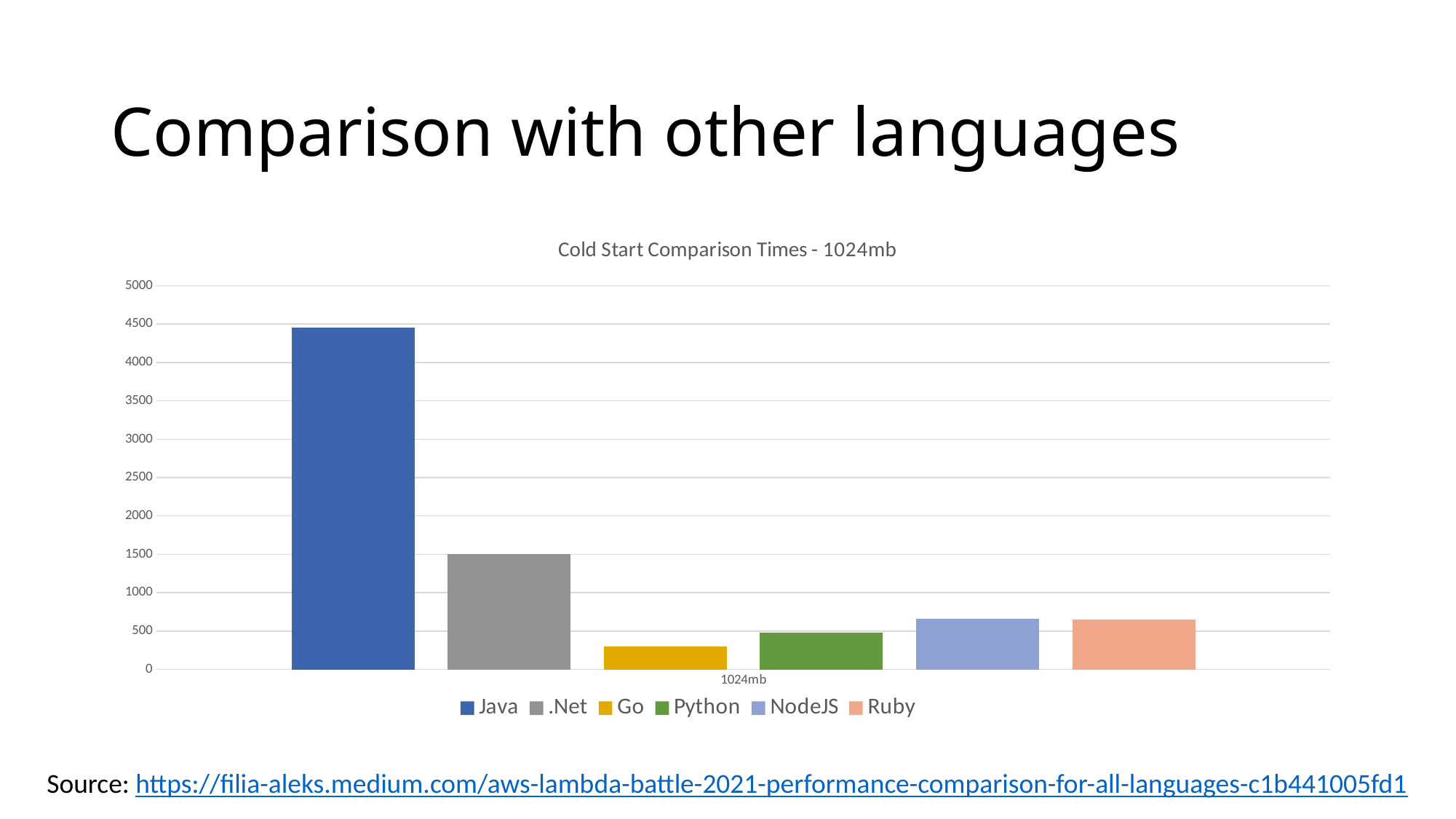
What is the title of the chart? Cold Start Comparison Times - 1024mb Is the value for Go greater or less than 500? less Is the value for NodeJS greater or less than 500? greater What type of chart is shown on the slide? bar chart How many series does the legend list? 6 Which language has the highest cold start time in the chart? Java Which language has the lowest cold start time in the chart? Go What is the label shown on the x axis under the bars? 1024mb Is the value for Java greater or less than 4000? greater Which is larger, the value for .Net or the value for Python? .Net